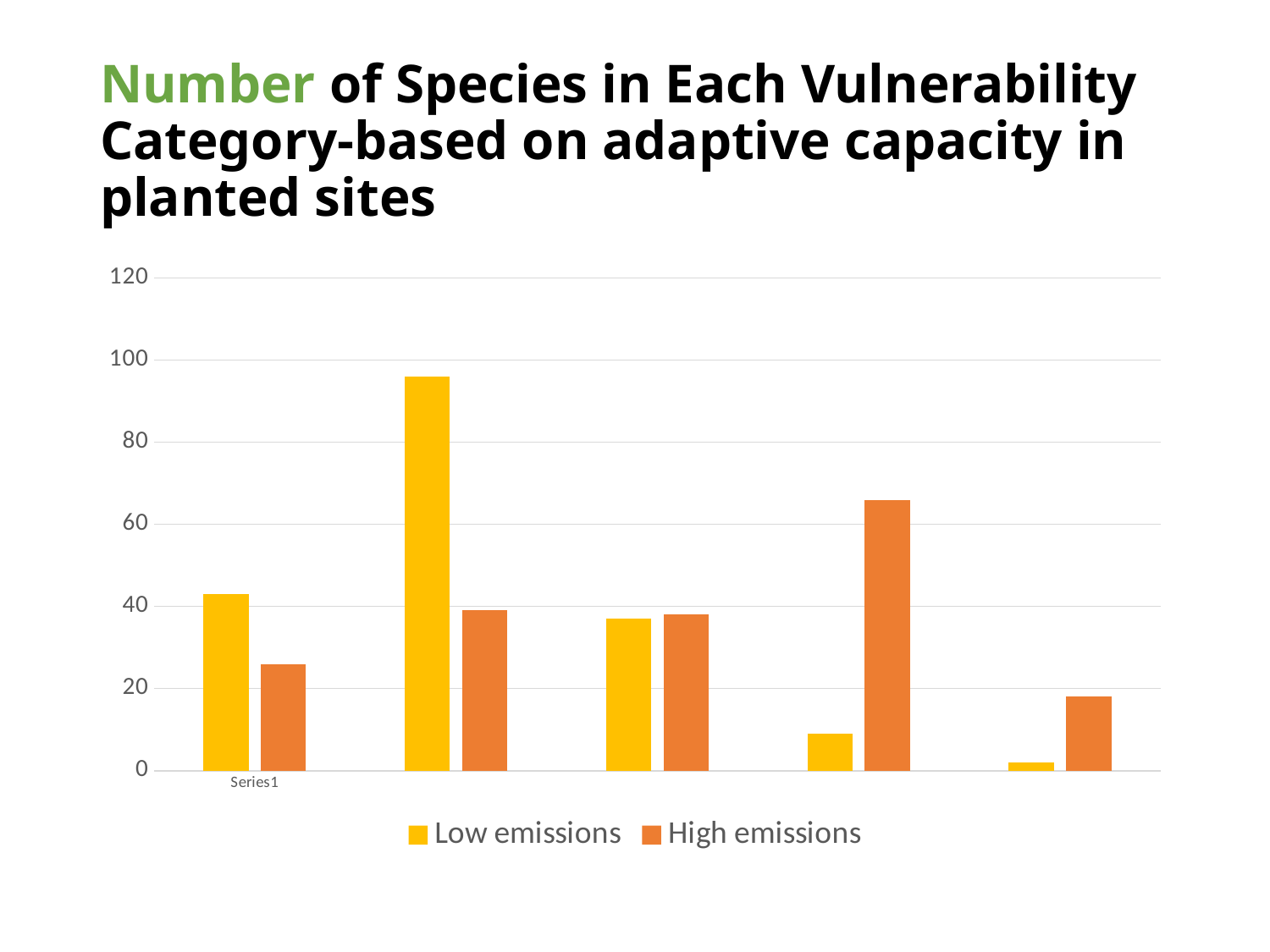
How many groups of bars are plotted in the chart? 5 How many series does the legend list? 2 Which group of bars has the shortest Low emissions bar? the fifth (last) group Which series contains the tallest bar in the whole chart? Low emissions Which group of bars has the tallest Low emissions bar? the second group For Series1, which series has the larger value, Low emissions or High emissions? Low emissions Is the Low emissions value for Series1 greater or less than 60? less In the fourth group of bars, which series has the larger value, Low emissions or High emissions? High emissions Is the Low emissions value in the second group greater or less than 80? greater Is the High emissions value in the fifth group greater or less than 40? less What are the two series named in the legend? Low emissions and High emissions What kind of chart is shown on the slide? bar chart